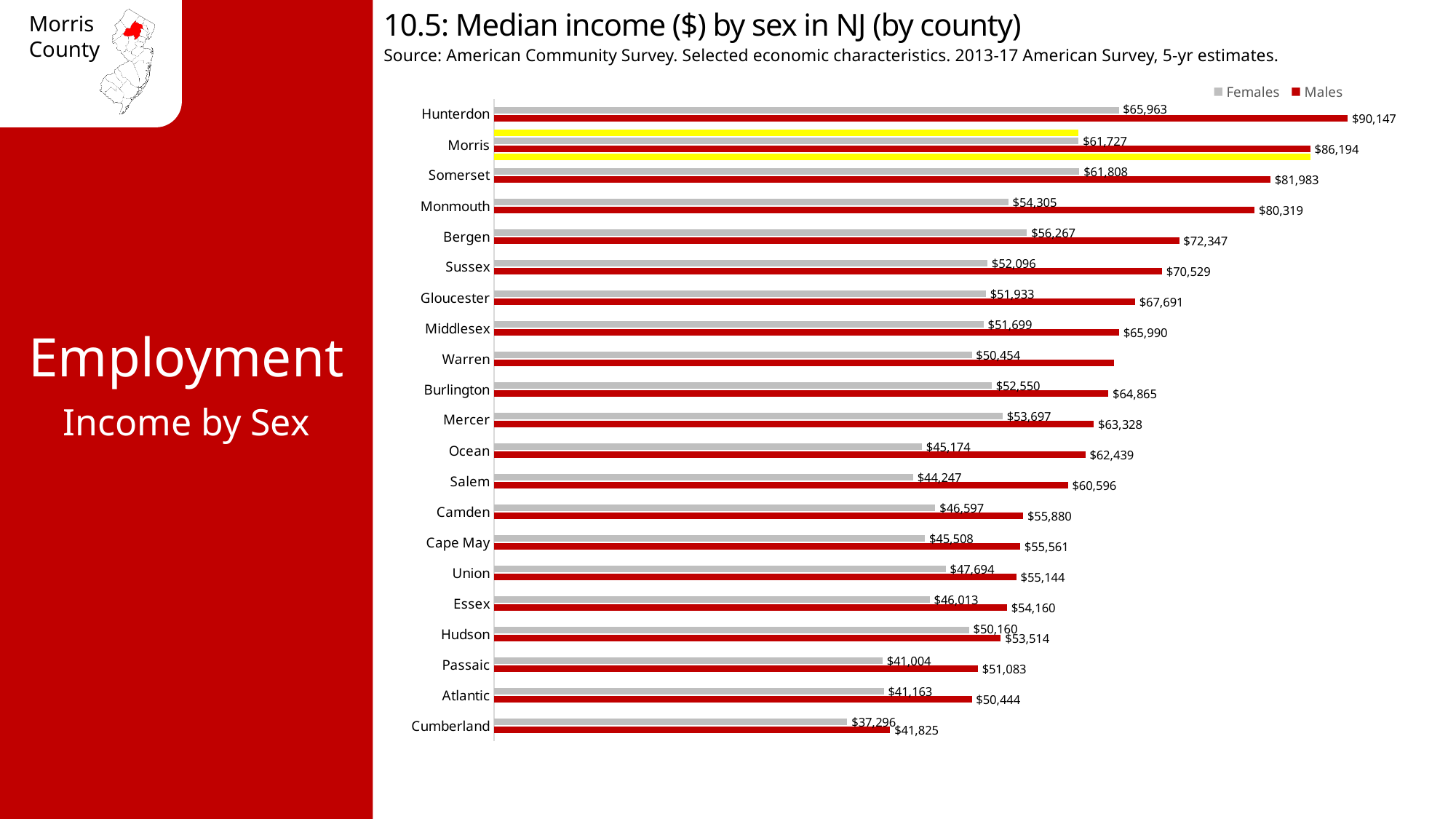
Which county has the lowest median income for females? Cumberland What is the difference between the male and female median incomes in Hunterdon County? $24,184 What is the median income for females in Morris County? $61,727 What is the difference between the male and female median incomes in Cumberland County? $4,529 How many counties are shown in the chart? 21 What is the median income for females in Ocean County? $45,174 Which is larger, the female median income in Hudson County or in Passaic County? Hudson What is the median income for males in Cumberland County? $41,825 What is the median income for males in Hunterdon County? $90,147 Which county has the highest median income for males? Hunterdon What kind of chart is shown on the slide? Bar chart How many series does the legend list? 2